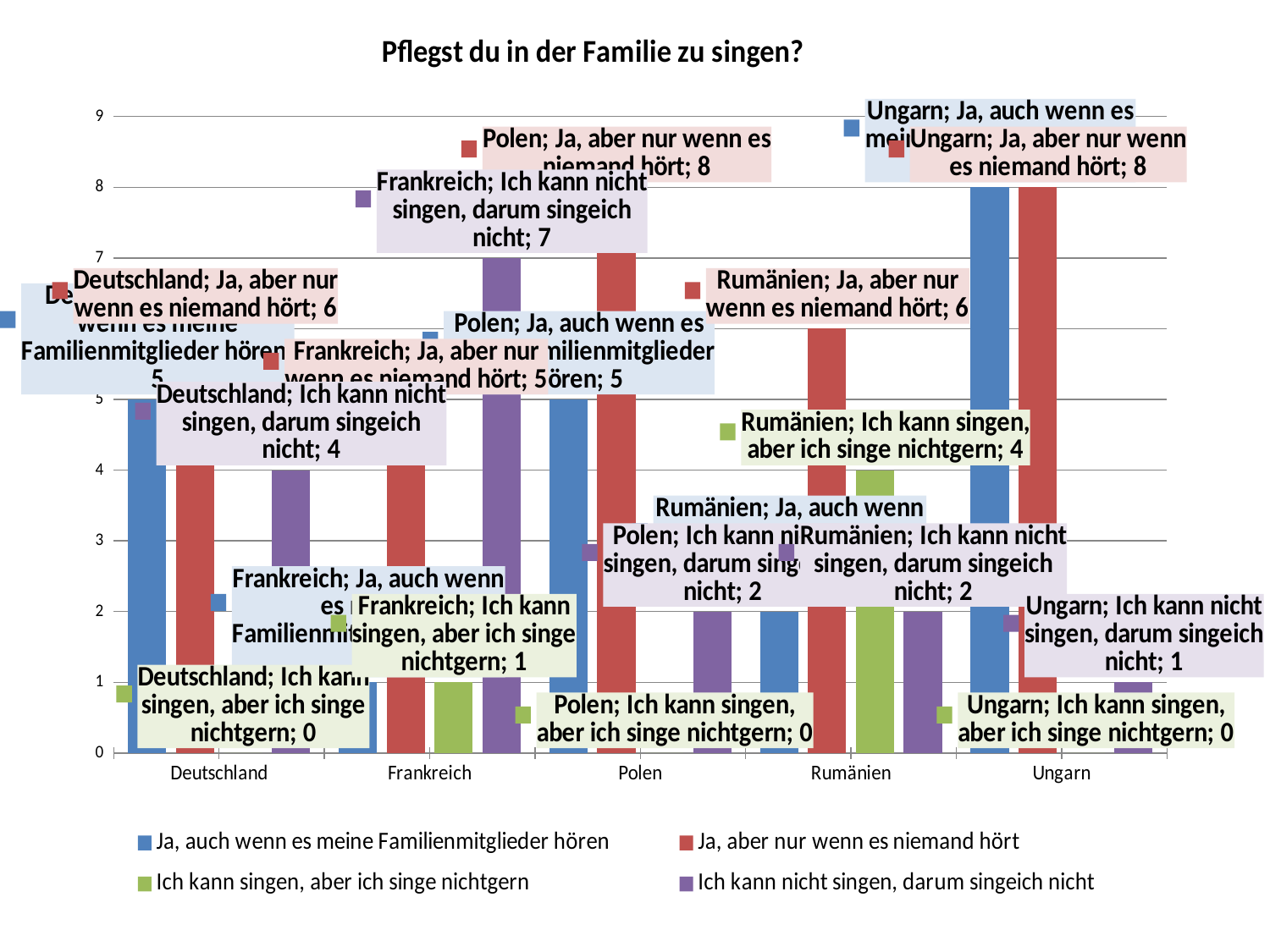
What is the title of the chart? Pflegst du in der Familie zu singen? Which country has the highest value in the series "Ich kann nicht singen, darum singeich nicht"? Frankreich How many countries are shown on the x axis? 5 What is the difference between the values for Polen in "Ja, aber nur wenn es niemand hört" (8) and "Ja, auch wenn es meine Familienmitglieder hören" (5)? 3 What is the value for Polen in the series "Ja, aber nur wenn es niemand hört"? 8 What is the value for Frankreich in the series "Ich kann nicht singen, darum singeich nicht"? 7 For Deutschland, which is larger: "Ja, aber nur wenn es niemand hört" or "Ich kann nicht singen, darum singeich nicht"? Ja, aber nur wenn es niemand hört What is the value for Rumänien in the series "Ich kann singen, aber ich singe nichtgern"? 4 What is the value for Deutschland in the series "Ja, aber nur wenn es niemand hört"? 6 How many series does the legend list? 4 What kind of chart is shown on the slide? bar chart